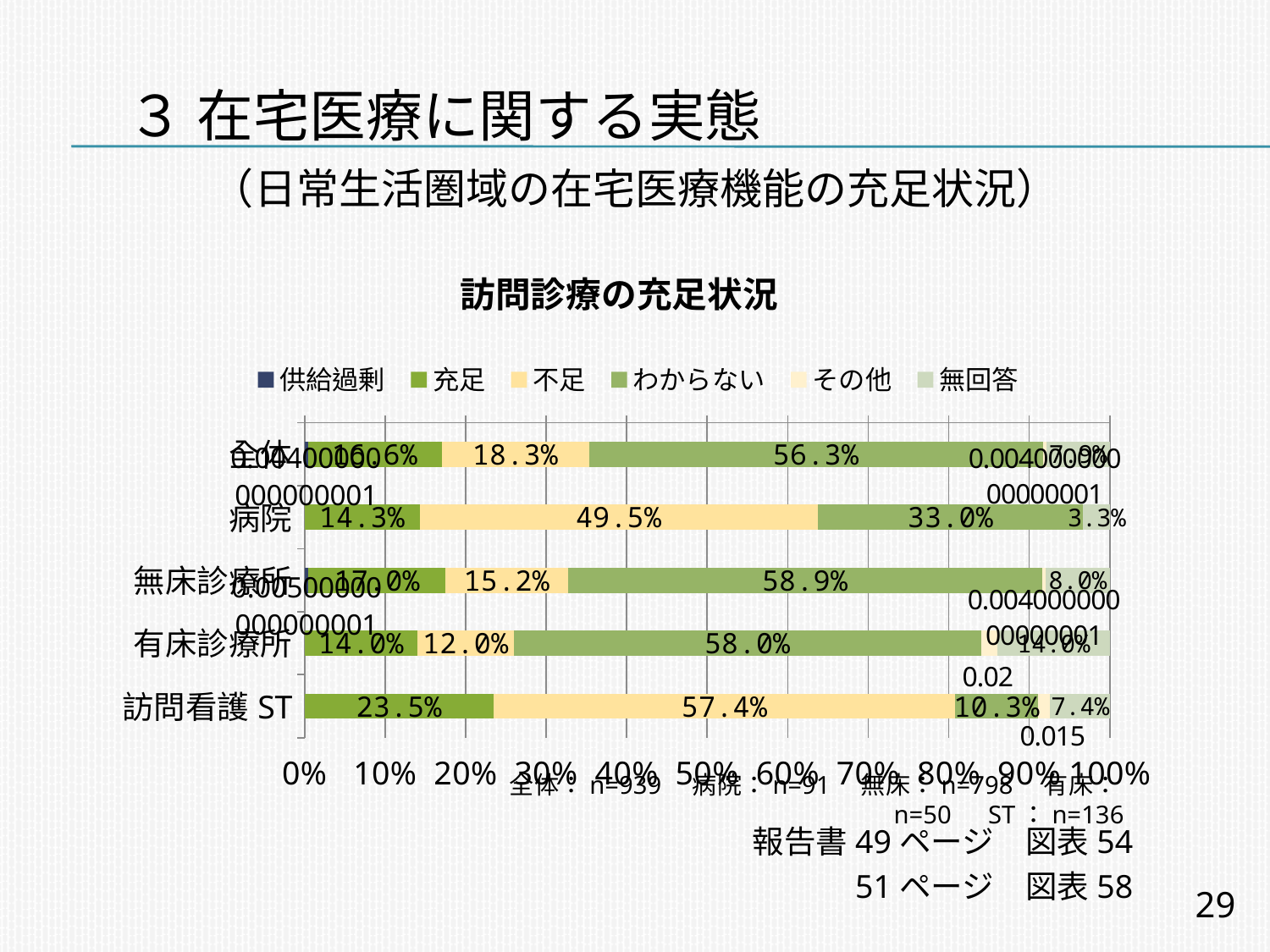
What is the difference between the 不足 values for 訪問看護ST and 病院? 7.9% What is the 不足 value for 病院? 49.5% Which category has the highest 不足 value? 訪問看護ST How many series does the legend list? 6 What is the 無回答 value for 有床診療所? 14.0% What is the 充足 value for 訪問看護ST? 23.5% Which is larger, the 充足 value for 無床診療所 or for 有床診療所? 無床診療所 Which category has the lowest わからない value? 訪問看護ST How many categories are plotted on the y axis? 5 What is the title of the chart? 訪問診療の充足状況 What is the わからない value for 無床診療所? 58.9% What type of chart is shown on the slide? stacked bar chart